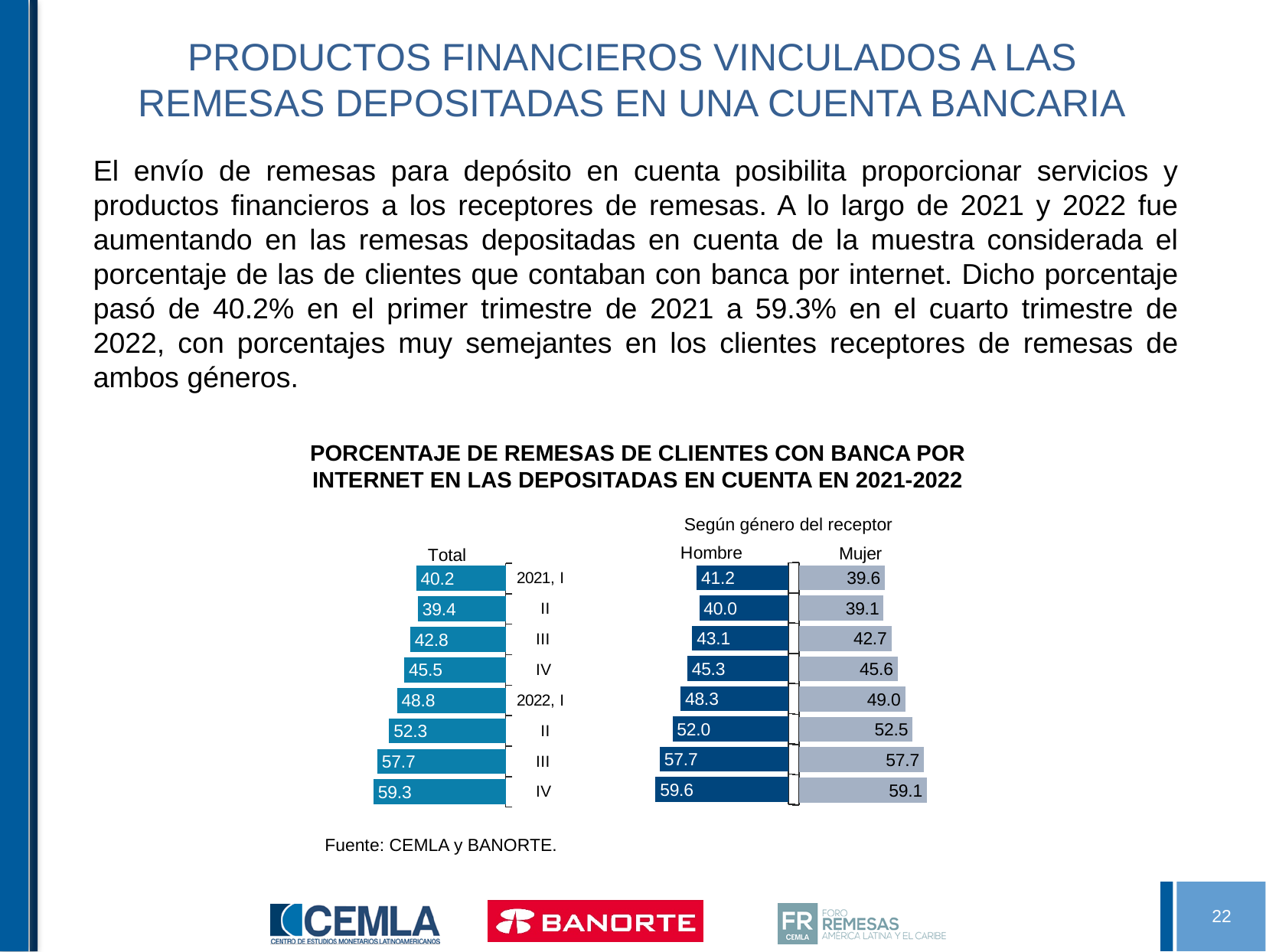
In the Total chart, what is the difference between the values for 2022, IV and 2021, I? 19.1 In the Según género del receptor chart, what is the Hombre value for 2022, II? 52.0 How many series does the Según género del receptor chart show? 2 In the Total chart, which quarter has the lowest value? 2021, II How many quarters are shown in the Total chart? 8 In the Total chart, what is the value for 2022, IV? 59.3 In the Total chart, do the values generally rise or fall from 2021, II to 2022, IV? Rise In the Según género del receptor chart, which is larger for 2022, I: the Hombre value or the Mujer value? Mujer In the Según género del receptor chart, which quarter has the highest Hombre value? 2022, IV In the Total chart, what is the value for 2021, I? 40.2 In the Según género del receptor chart, what is the Mujer value for 2021, IV? 45.6 What type of chart is the Total chart? Bar chart